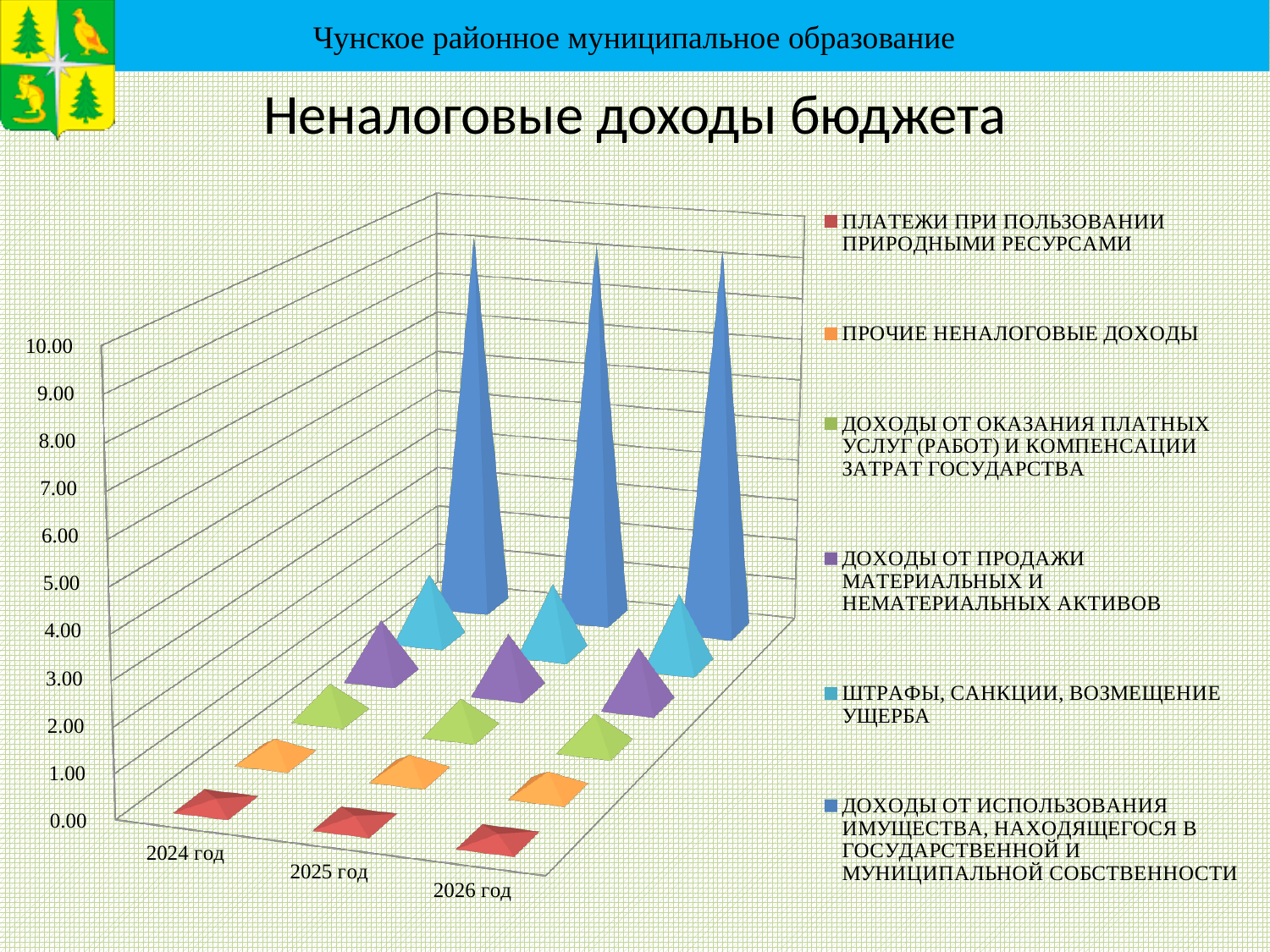
How many years (categories) are shown on the x axis of the chart? 3 What colour represents the series ШТРАФЫ, САНКЦИИ, ВОЗМЕЩЕНИЕ УЩЕРБА in the chart? light blue (cyan) Is the value for ПРОЧИЕ НЕНАЛОГОВЫЕ ДОХОДЫ in 2026 год greater or less than 2.00? less Is the value for ДОХОДЫ ОТ ИСПОЛЬЗОВАНИЯ ИМУЩЕСТВА in 2025 год greater or less than 5.00? greater Which series has the highest value in 2024 год? ДОХОДЫ ОТ ИСПОЛЬЗОВАНИЯ ИМУЩЕСТВА, НАХОДЯЩЕГОСЯ В ГОСУДАРСТВЕННОЙ И МУНИЦИПАЛЬНОЙ СОБСТВЕННОСТИ In 2025 год, which is larger: ДОХОДЫ ОТ ПРОДАЖИ МАТЕРИАЛЬНЫХ И НЕМАТЕРИАЛЬНЫХ АКТИВОВ or ПРОЧИЕ НЕНАЛОГОВЫЕ ДОХОДЫ? ДОХОДЫ ОТ ПРОДАЖИ МАТЕРИАЛЬНЫХ И НЕМАТЕРИАЛЬНЫХ АКТИВОВ Is the value for ПЛАТЕЖИ ПРИ ПОЛЬЗОВАНИИ ПРИРОДНЫМИ РЕСУРСАМИ in 2024 год greater or less than 1.00? less In 2024 год, which is larger: ДОХОДЫ ОТ ИСПОЛЬЗОВАНИЯ ИМУЩЕСТВА or ШТРАФЫ, САНКЦИИ, ВОЗМЕЩЕНИЕ УЩЕРБА? ДОХОДЫ ОТ ИСПОЛЬЗОВАНИЯ ИМУЩЕСТВА What kind of chart is shown on the slide? bar chart How many series does the chart legend list? 6 What is the title of the chart? Неналоговые доходы бюджета Which series has the lowest value in 2026 год? ПЛАТЕЖИ ПРИ ПОЛЬЗОВАНИИ ПРИРОДНЫМИ РЕСУРСАМИ